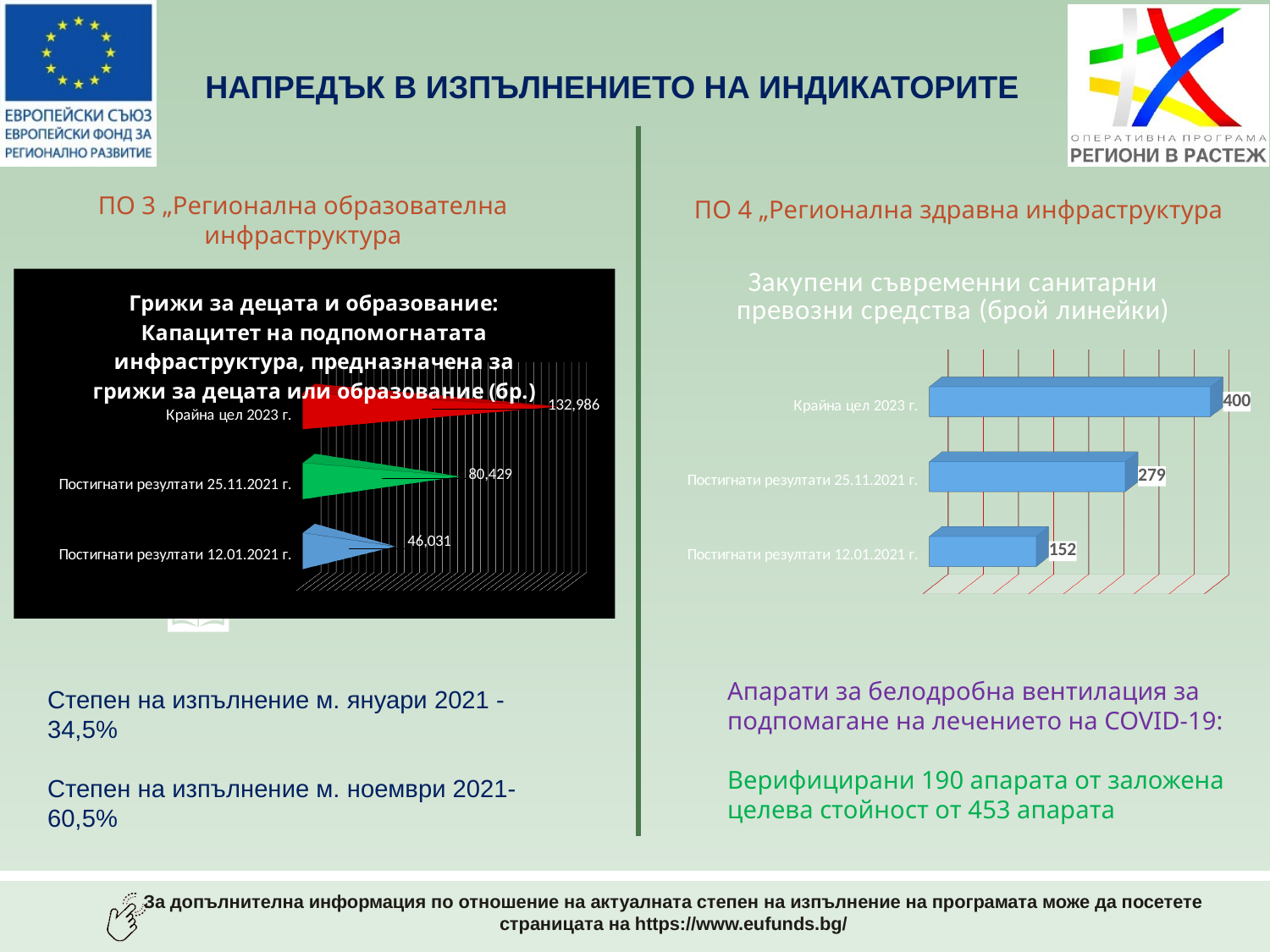
In the left chart (Грижи за децата и образование), how many categories are plotted? 3 In the left chart (Грижи за децата и образование), which category has the lowest value? Постигнати резултати 12.01.2021 г. In the right chart (Закупени съвременни санитарни превозни средства), what is the value for Постигнати резултати 12.01.2021 г.? 152 In the left chart (Грижи за децата и образование), what is the value for Крайна цел 2023 г.? 132,986 In the right chart (Закупени съвременни санитарни превозни средства), which category has the highest value? Крайна цел 2023 г. In the right chart (Закупени съвременни санитарни превозни средства), what is the difference between Крайна цел 2023 г. and Постигнати резултати 25.11.2021 г.? 121 What kind of chart is the right chart (Закупени съвременни санитарни превозни средства)? Bar chart In the right chart (Закупени съвременни санитарни превозни средства), what is the value for Крайна цел 2023 г.? 400 In the right chart (Закупени съвременни санитарни превозни средства), what is the value for Постигнати резултати 25.11.2021 г.? 279 In the left chart (Грижи за децата и образование), what is the difference between Постигнати резултати 25.11.2021 г. and Постигнати резултати 12.01.2021 г.? 34,398 In the left chart (Грижи за децата и образование), what is the value for Постигнати резултати 25.11.2021 г.? 80,429 In the left chart (Грижи за децата и образование), what is the value for Постигнати резултати 12.01.2021 г.? 46,031